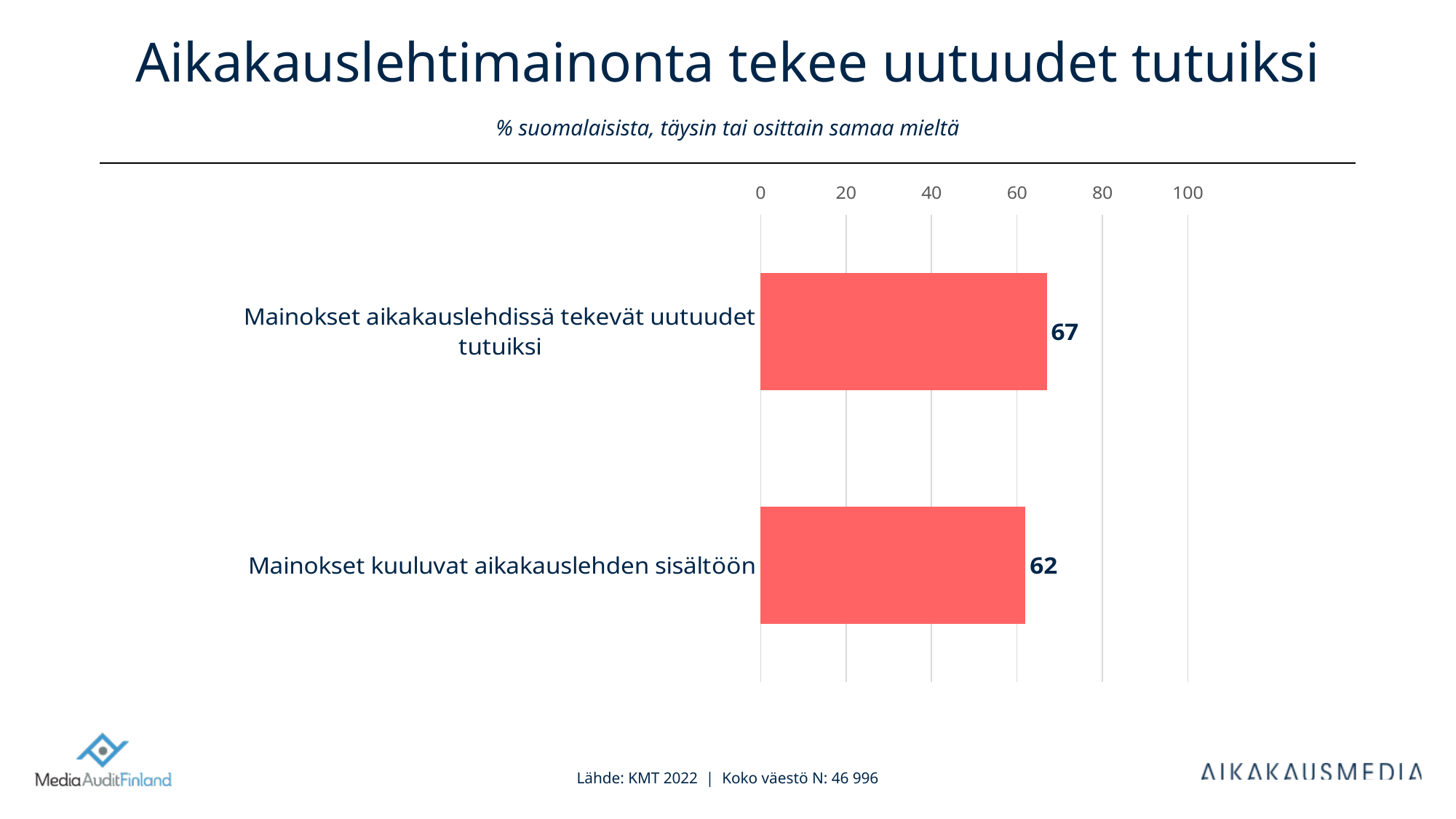
What is the value for "Mainokset kuuluvat aikakauslehden sisältöön"? 62 Is the value for "Mainokset kuuluvat aikakauslehden sisältöön" greater or less than 80? less What is the value for "Mainokset aikakauslehdissä tekevät uutuudet tutuiksi"? 67 What kind of chart is shown on the slide? Bar chart What is the maximum value shown on the chart's axis? 100 Which is larger: the value for "Mainokset aikakauslehdissä tekevät uutuudet tutuiksi" or for "Mainokset kuuluvat aikakauslehden sisältöön"? Mainokset aikakauslehdissä tekevät uutuudet tutuiksi How many categories are shown in the chart? 2 What is the difference between the values for "Mainokset aikakauslehdissä tekevät uutuudet tutuiksi" and "Mainokset kuuluvat aikakauslehden sisältöön"? 5 Is the value for "Mainokset aikakauslehdissä tekevät uutuudet tutuiksi" greater or less than 60? greater Which category has the highest value? Mainokset aikakauslehdissä tekevät uutuudet tutuiksi What is the title of the slide? Aikakauslehtimainonta tekee uutuudet tutuiksi Which category has the lowest value? Mainokset kuuluvat aikakauslehden sisältöön